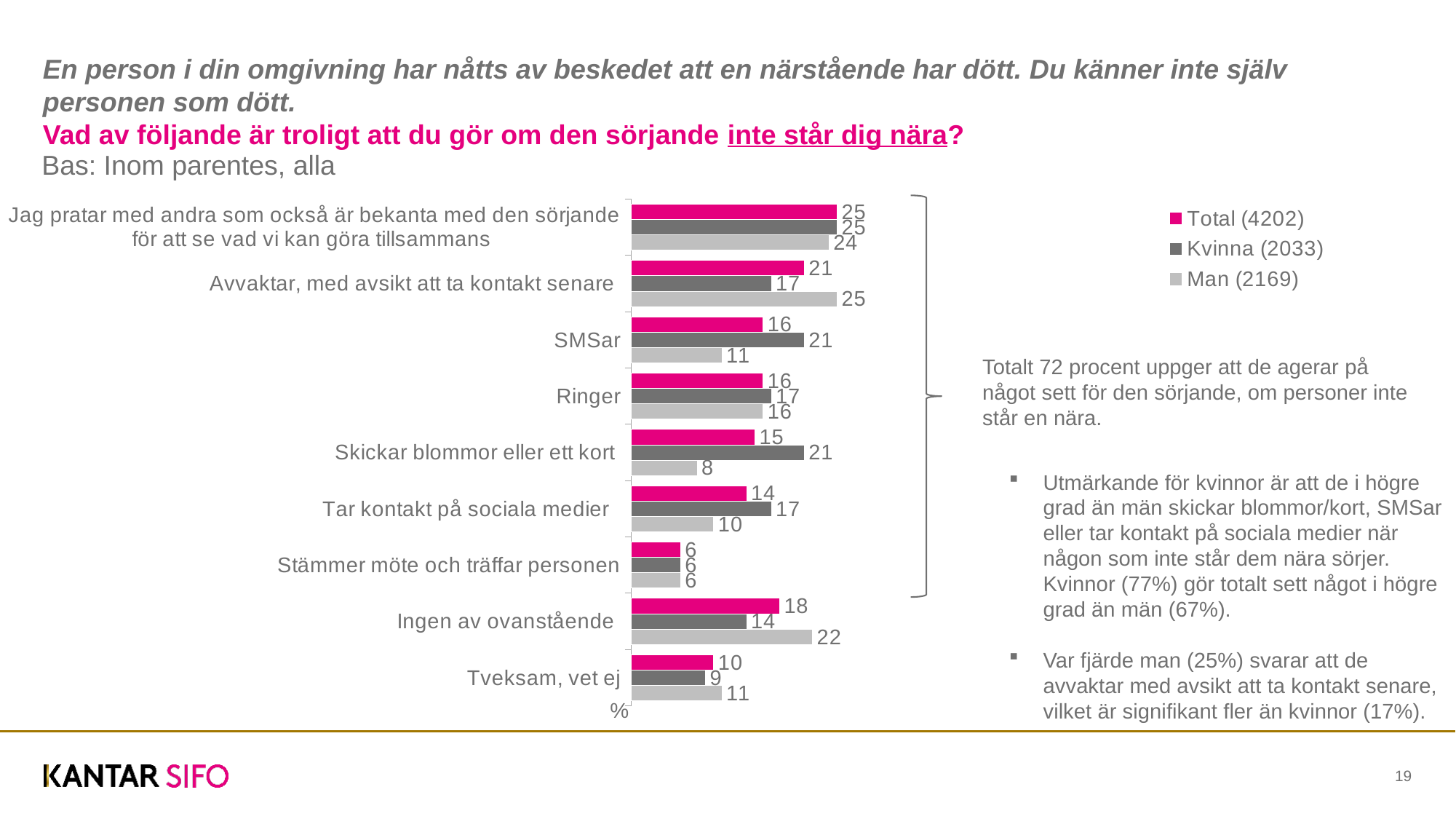
For "Ingen av ovanstående", which is larger: the Kvinna (2033) value or the Man (2169) value? Man (2169) What is the value for Man (2169) for "Avvaktar, med avsikt att ta kontakt senare"? 25 What kind of chart is shown on the slide? Bar chart For "Tar kontakt på sociala medier", which is larger: the Kvinna (2033) value or the Man (2169) value? Kvinna (2033) How many categories are shown on the chart? 9 What is the difference between the Kvinna (2033) and Man (2169) values for "SMSar"? 10 Which category has the lowest value for Kvinna (2033)? Stämmer möte och träffar personen How many series does the legend list? 3 What is the value for Kvinna (2033) for "Skickar blommor eller ett kort"? 21 What is the difference between the Kvinna (2033) and Man (2169) values for "Skickar blommor eller ett kort"? 13 Which category has the highest value for Man (2169)? Avvaktar, med avsikt att ta kontakt senare What is the value for Total (4202) for "Ingen av ovanstående"? 18